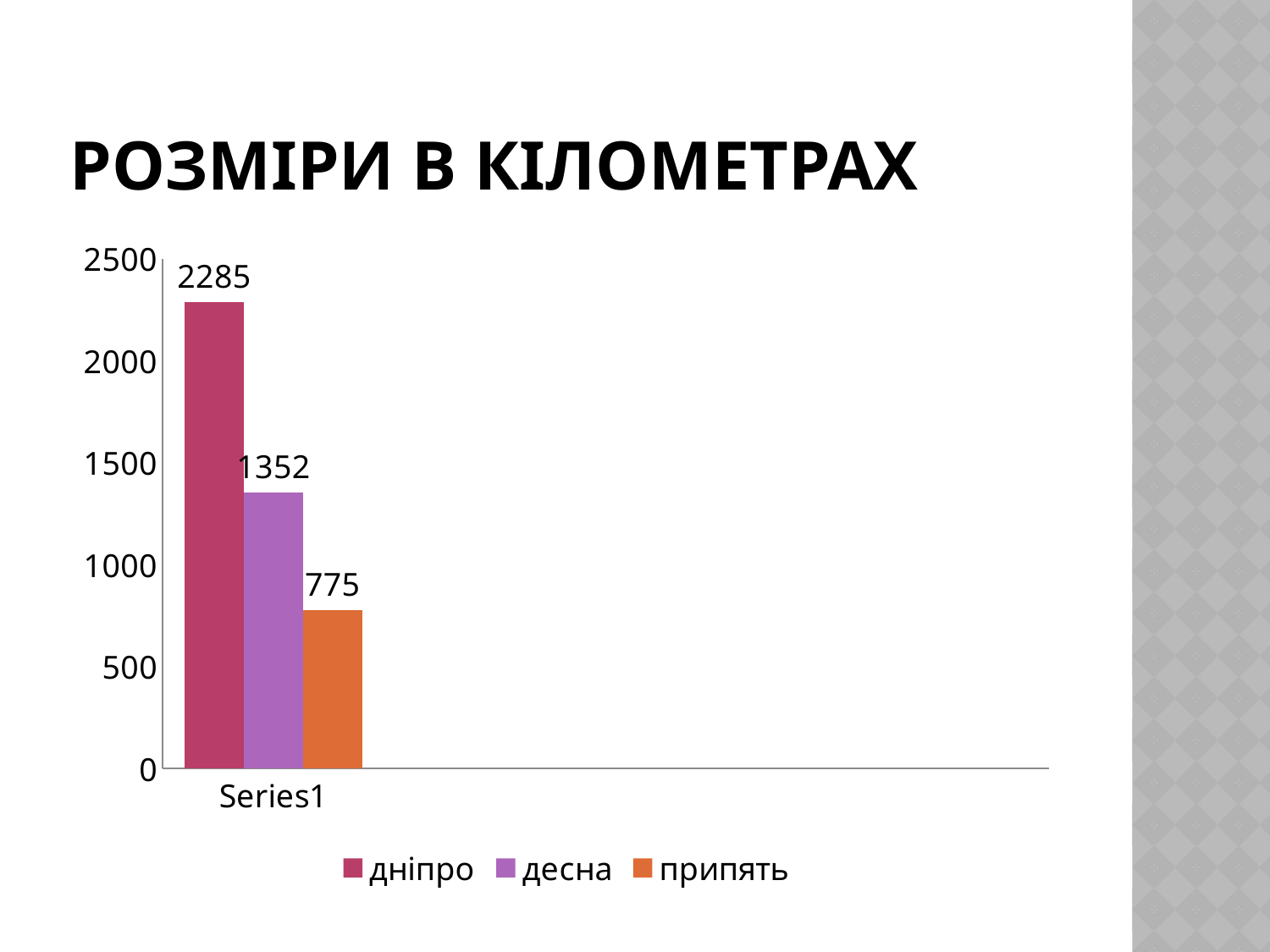
Which river has the lowest value? припять Is the value for припять greater or less than 1000? less What is the difference between the values for десна and припять? 577 What is the value for дніпро? 2285 What is the title of the slide? РОЗМІРИ В КІЛОМЕТРАХ How many series does the legend list? 3 What is the value for припять? 775 Which is larger, the value for десна or the value for припять? десна What kind of chart is shown on the slide? bar chart What is the difference between the values for дніпро and десна? 933 What is the value for десна? 1352 Which river has the highest value? дніпро